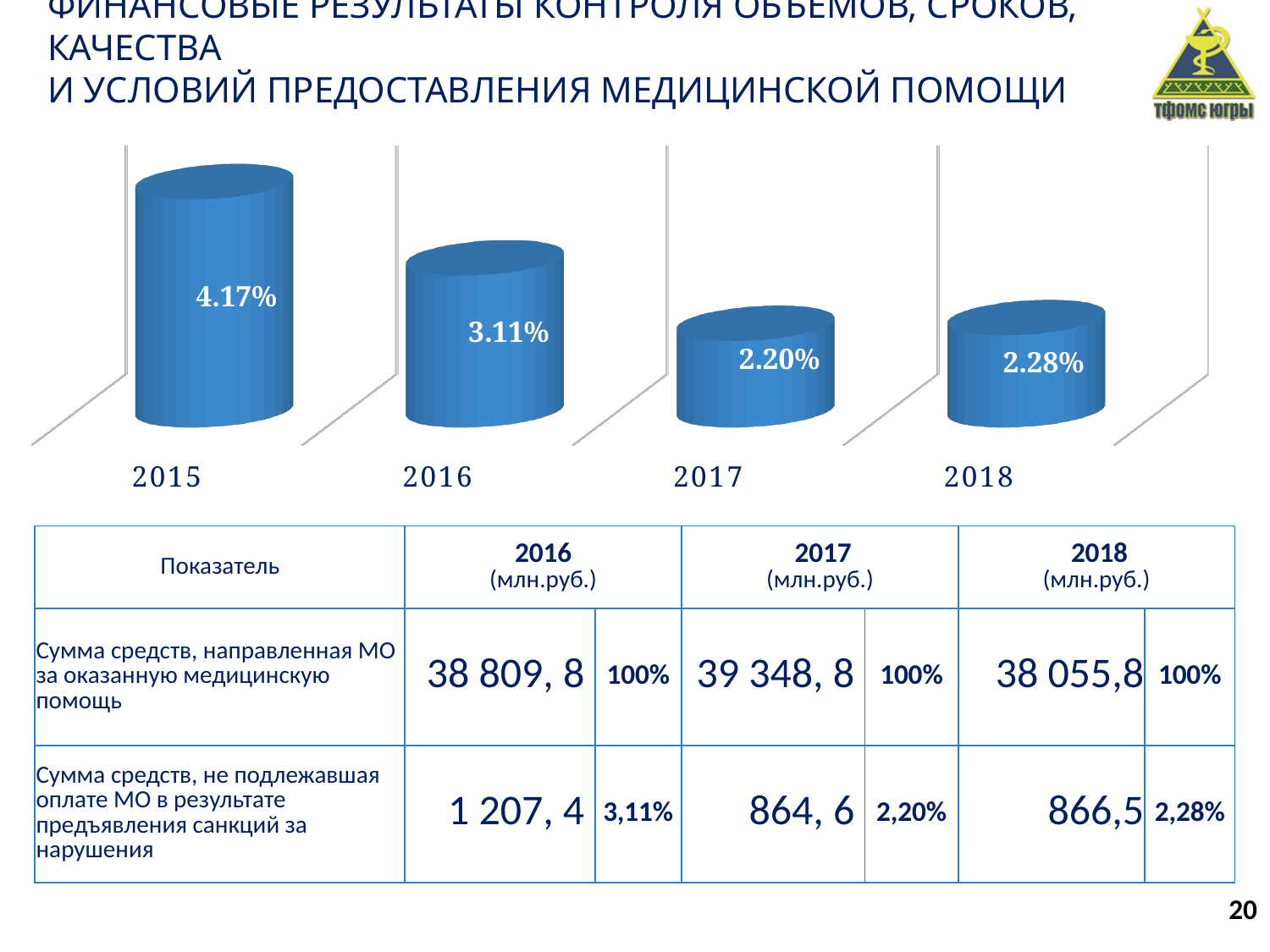
What kind of chart is shown on the slide? Bar chart What is the value shown for 2017 in the chart? 2.20% Which is larger in the chart, the value for 2016 or the value for 2018? 2016 What is the value shown for 2016 in the chart? 3.11% How many years are shown in the chart? 4 What is the difference between the values for 2015 and 2016 in the chart? 1.06% What is the value shown for 2018 in the chart? 2.28% Which year has the lowest value in the chart? 2017 What is the difference between the values for 2018 and 2017 in the chart? 0.08% Which year has the highest value in the chart? 2015 What is the value shown for 2015 in the chart? 4.17% Do the values in the chart generally rise or fall from 2015 to 2017? Fall